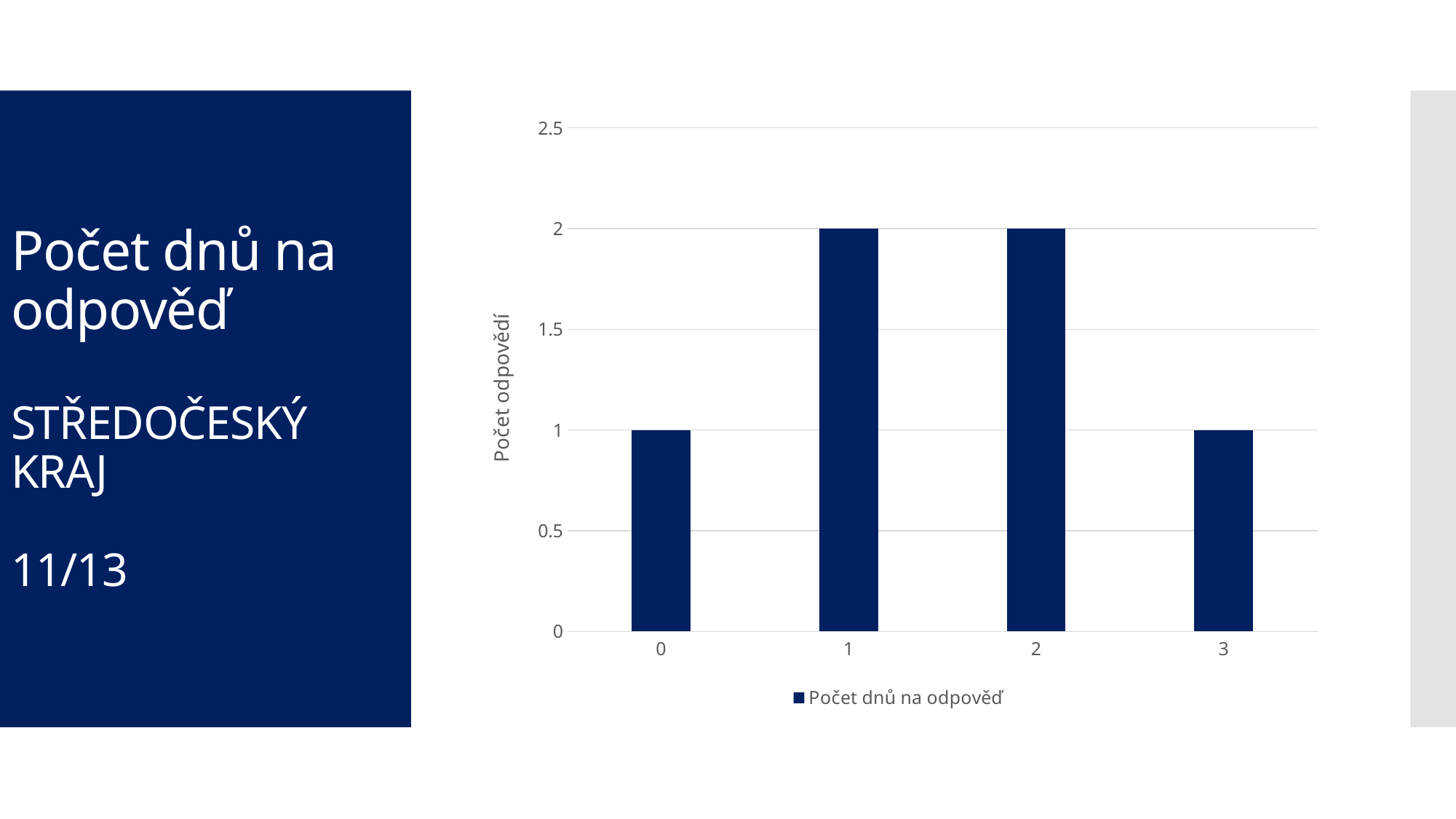
What is the difference between the value for category 1 and the value for category 3? 1 How many series does the legend list? 1 What is the value for category 1? 2 What is the value for category 3? 1 Which is larger, the value for category 2 or the value for category 3? category 2 How many categories are shown on the x axis? 4 What is the value for category 2? 2 Which is larger, the value for category 0 or the value for category 1? category 1 What is the name of the series shown in the legend? Počet dnů na odpověď What is the label of the vertical axis? Počet odpovědí What is the value for category 0? 1 What kind of chart is shown on the slide? bar chart